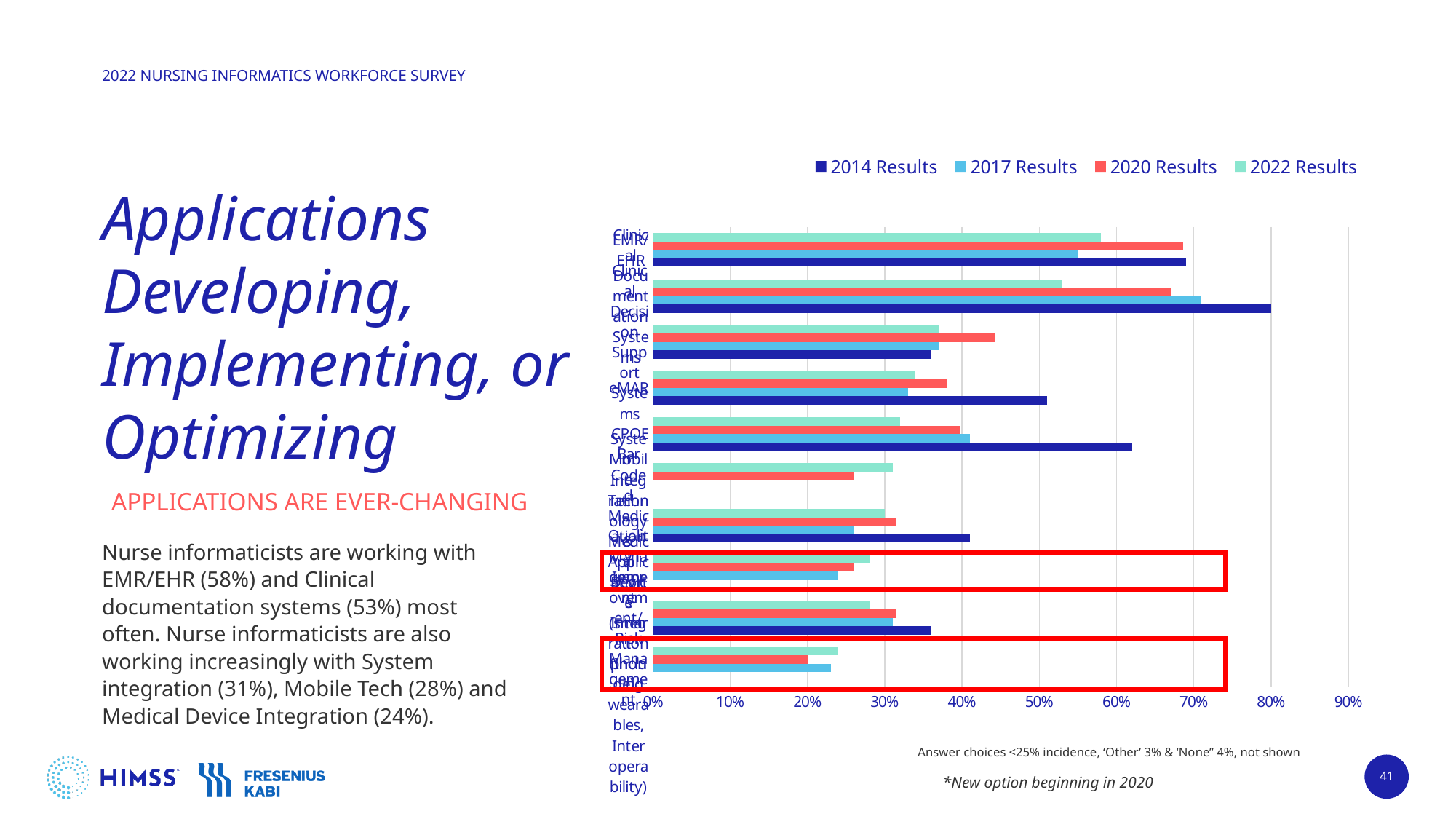
Is the 2022 Results value for the bottom category greater or less than 30%? less For the second category from the top, which is larger: the 2014 Results bar or the 2022 Results bar? 2014 Results What kind of chart is shown on the slide? bar chart How many categories are plotted on the chart? 10 How many series does the chart legend list? 4 Which series has the longest bar on the chart? 2014 Results What is the highest value shown on the chart's horizontal axis? 90% Is the 2020 Results value for the bottom category greater or less than 30%? less Is the 2022 Results value for the top category (EMR/EHR) greater or less than 50%? greater What is the value of the longest bar on the chart? 80% Which years are listed in the chart legend? 2014, 2017, 2020, 2022